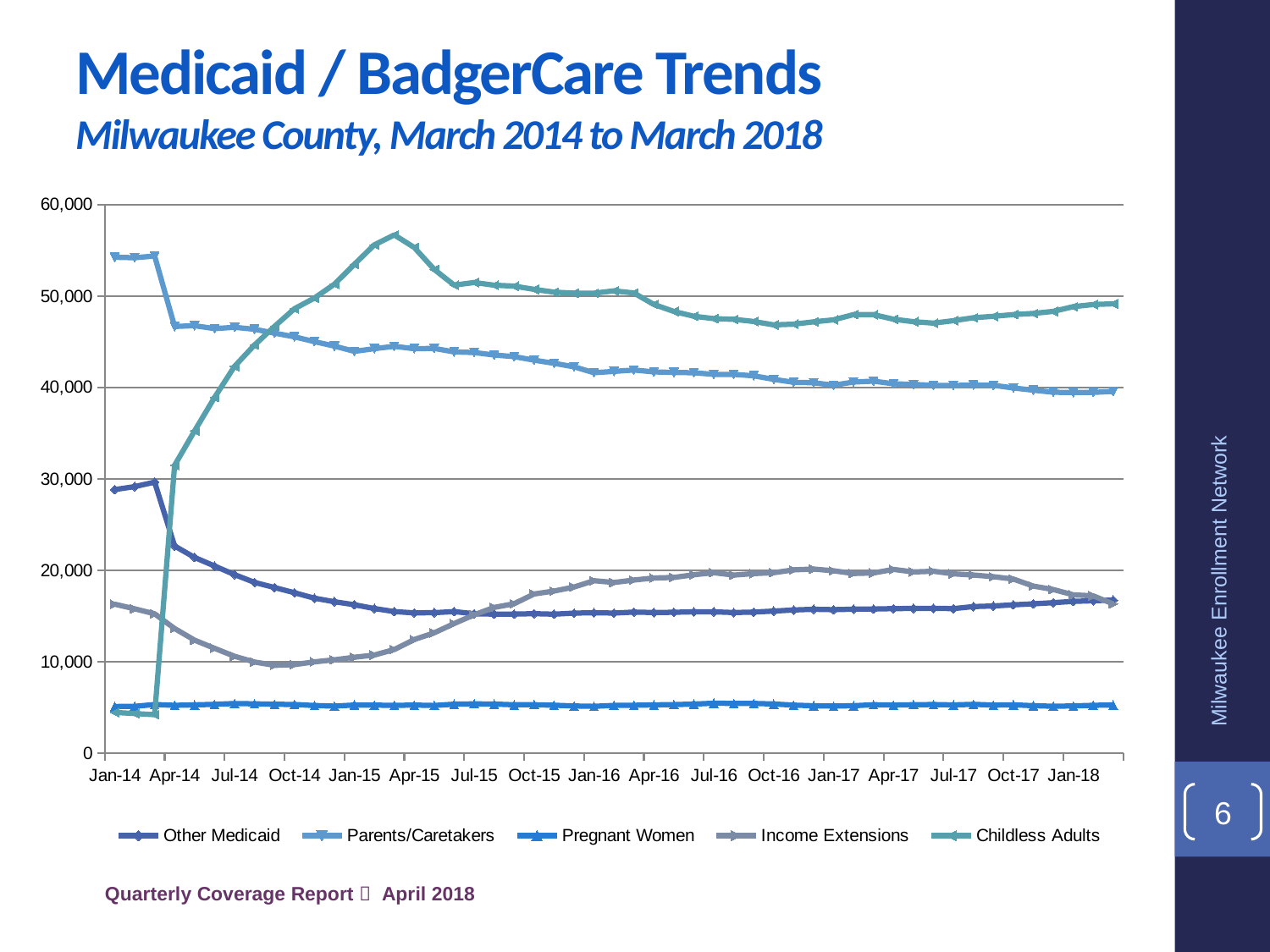
Is the value for Parents/Caretakers at Jan-14 greater or less than 50,000? greater At Apr-14, which is larger: Childless Adults or Other Medicaid? Childless Adults What is the title of the slide containing the chart? Medicaid / BadgerCare Trends What kind of chart is shown on the slide? line chart Is the value for Other Medicaid at Jan-18 greater or less than 20,000? less Do the values for Childless Adults rise or fall from Jan-14 to Apr-15? rise Do the values for Parents/Caretakers rise or fall from Jan-14 to Jan-18? fall How many series does the legend list? 5 Which series has the highest value at Jan-18? Childless Adults At Jan-16, which is larger: Income Extensions or Other Medicaid? Income Extensions Is the value for Childless Adults at Jan-14 greater or less than 10,000? less